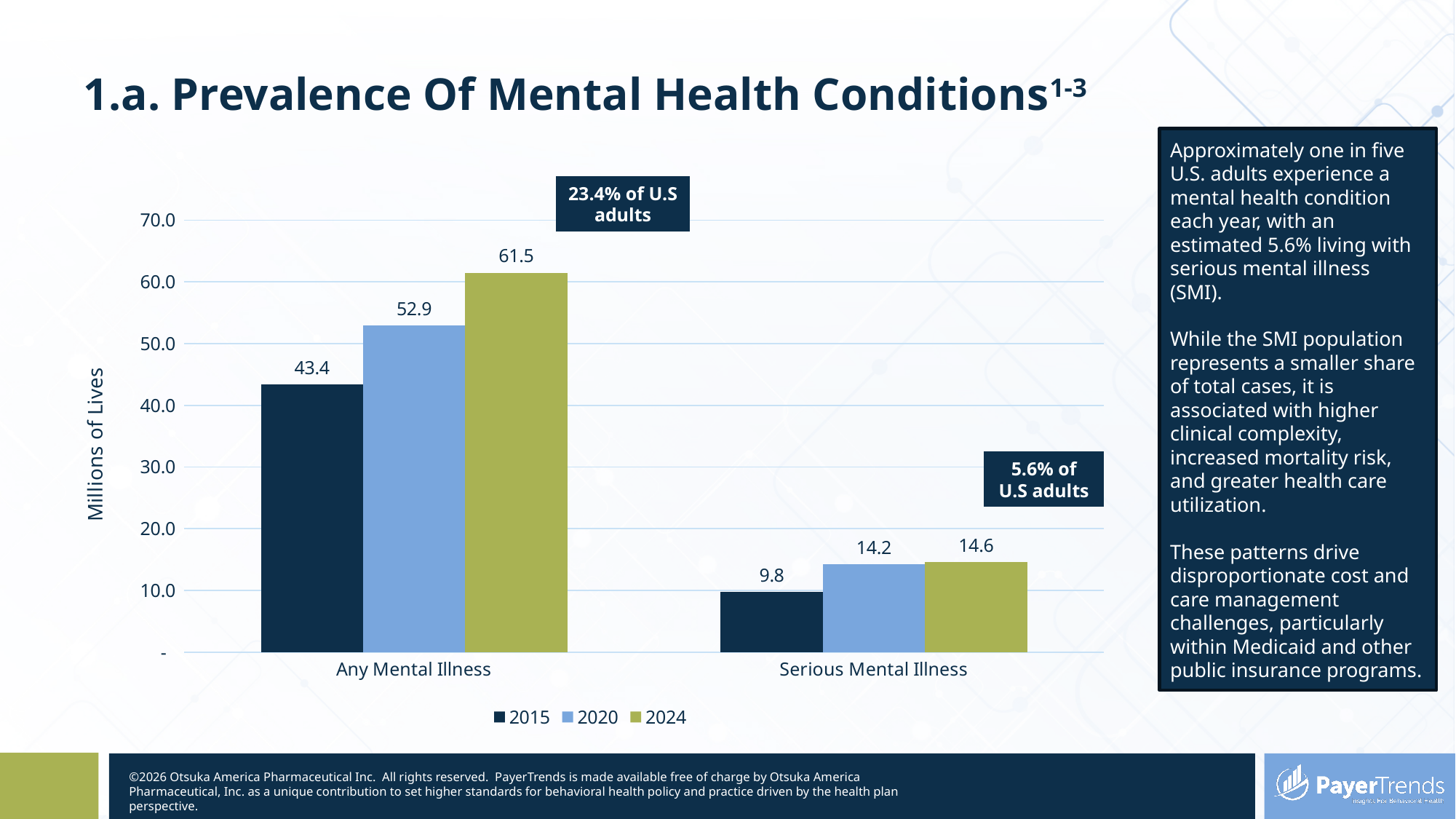
How many series does the legend list? 3 What is the difference between the 2024 and 2015 values for Any Mental Illness? 18.1 What kind of chart is shown on the slide? Bar chart Which year has the highest value for Serious Mental Illness? 2024 What is the value for Serious Mental Illness in 2015? 9.8 What is the label of the y axis? Millions of Lives What is the value for Any Mental Illness in 2024? 61.5 Which year has the lowest value for Any Mental Illness? 2015 How many categories are shown on the x axis? 2 What is the value for Any Mental Illness in 2020? 52.9 Which is larger: Any Mental Illness in 2015 or Serious Mental Illness in 2024? Any Mental Illness in 2015 What is the difference between the 2020 and 2015 values for Serious Mental Illness? 4.4